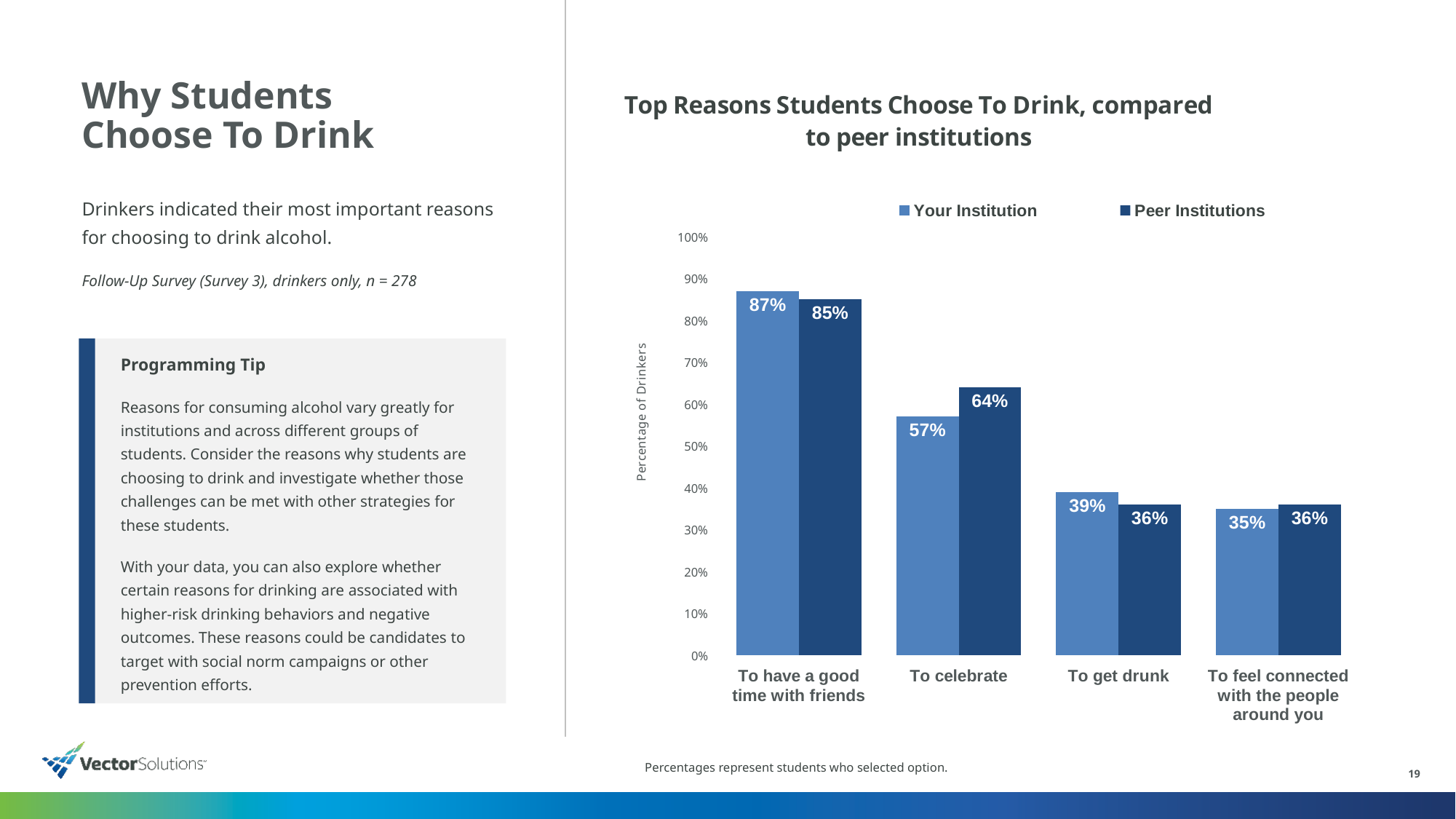
For 'To get drunk', which is larger: Your Institution or Peer Institutions? Your Institution What is the difference between the Peer Institutions and Your Institution values for 'To celebrate'? 7% What kind of chart is shown on the slide? Bar chart What is the Your Institution value for 'To get drunk'? 39% Which reason has the lowest value for Your Institution? To feel connected with the people around you How many reasons (categories) are shown on the x axis? 4 Which reason has the highest value for Your Institution? To have a good time with friends What is the Peer Institutions value for 'To celebrate'? 64% What percentage of drinkers at Your Institution chose 'To have a good time with friends' as a reason to drink? 87% How many series does the legend list? 2 What is the Peer Institutions value for 'To feel connected with the people around you'? 36% What is the label of the y axis? Percentage of Drinkers